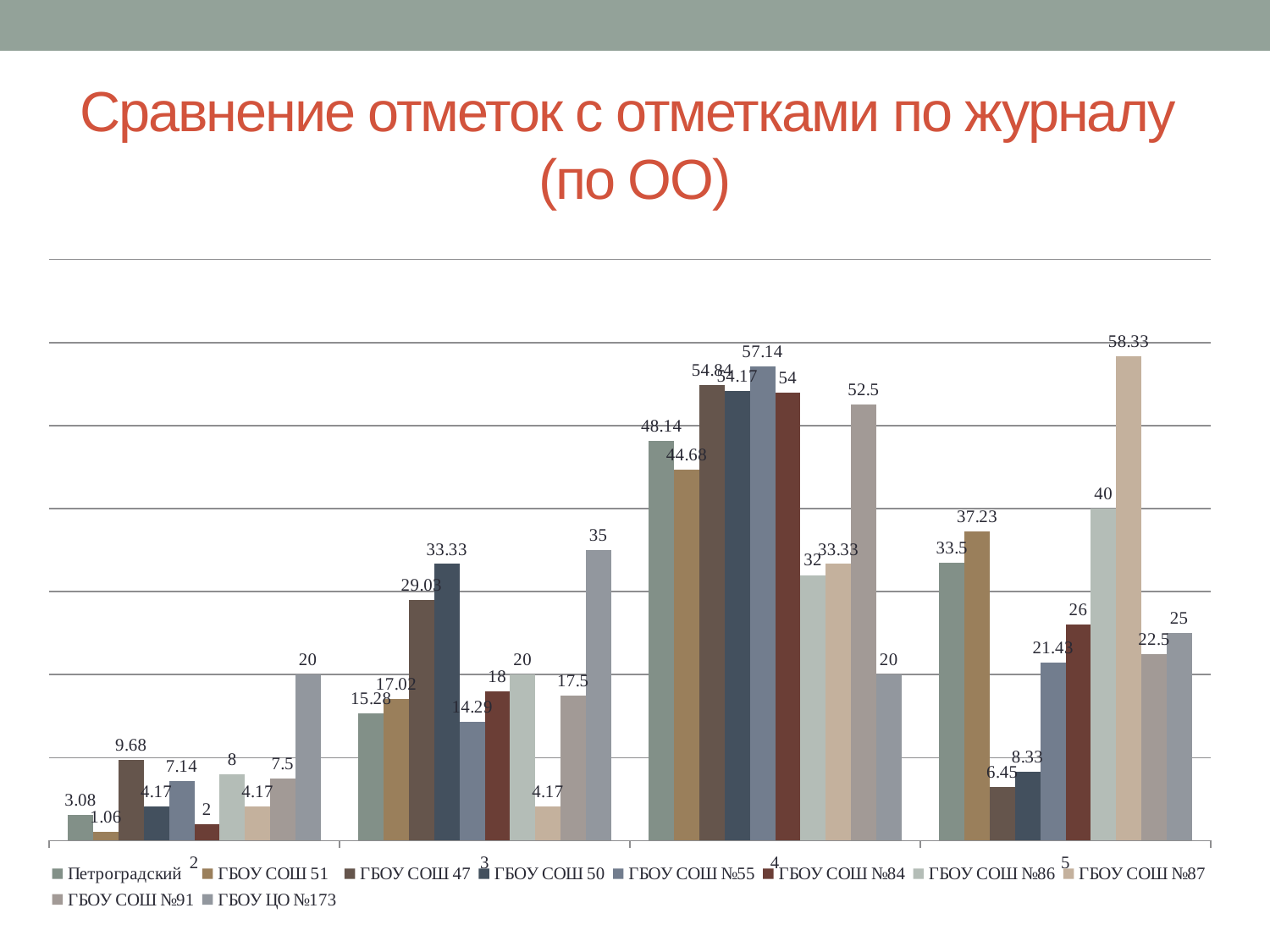
How many series does the legend list? 10 Which series has the highest value in category 5? ГБОУ СОШ №87 What is the value for ГБОУ СОШ №86 in category 5? 40 What is the value for Петроградский in category 3? 15.28 Which series has the highest value in category 4? ГБОУ СОШ №55 Which series has the lowest value in category 2? ГБОУ СОШ 51 What is the difference between the Петроградский values in category 4 and category 5? 14.64 What is the value for ГБОУ СОШ №87 in category 5? 58.33 What is the value for ГБОУ ЦО №173 in category 2? 20 How many categories are shown on the x axis? 4 In category 3, which is larger: ГБОУ СОШ 50 or ГБОУ СОШ 47? ГБОУ СОШ 50 What type of chart is shown on the slide? Bar chart